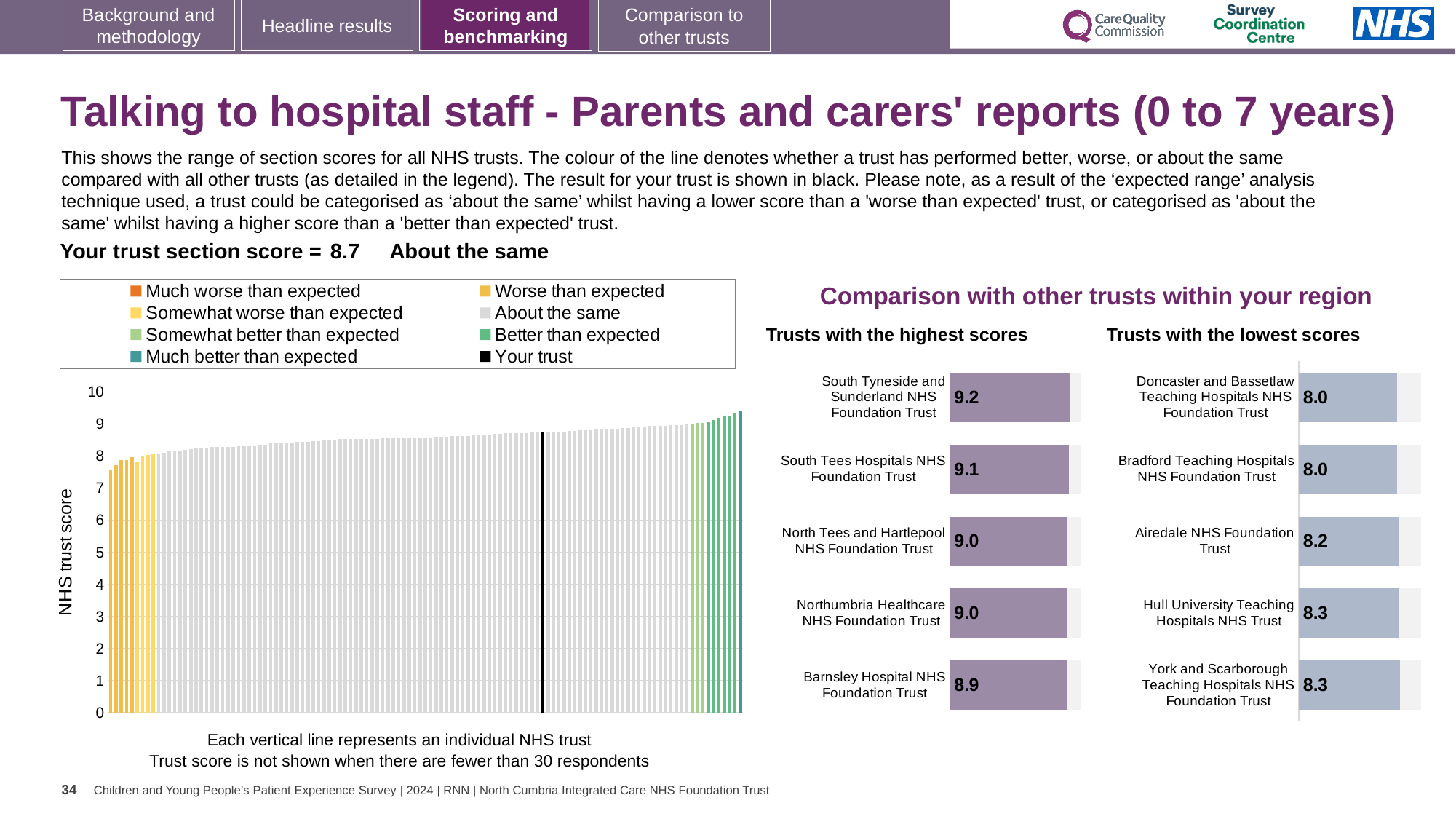
In the main 'NHS trust score' chart, is the value for the black 'Your trust' bar greater or less than 8? greater Which is larger: the score for South Tees Hospitals NHS Foundation Trust in the highest scores chart, or the score for Hull University Teaching Hospitals NHS Trust in the lowest scores chart? South Tees Hospitals NHS Foundation Trust In the 'Trusts with the highest scores' chart, which trust has the lowest score? Barnsley Hospital NHS Foundation Trust In the 'Trusts with the lowest scores' chart, what is the difference between the scores of Airedale NHS Foundation Trust and Doncaster and Bassetlaw Teaching Hospitals NHS Foundation Trust? 0.2 In the 'Trusts with the highest scores' chart, what is the difference between the scores of South Tyneside and Sunderland NHS Foundation Trust and Barnsley Hospital NHS Foundation Trust? 0.3 In the 'Trusts with the highest scores' chart, what is the score for South Tyneside and Sunderland NHS Foundation Trust? 9.2 How many entries does the legend of the main 'NHS trust score' chart list? 8 How many trusts are listed in the 'Trusts with the lowest scores' chart? 5 In the 'Trusts with the lowest scores' chart, what is the score for Airedale NHS Foundation Trust? 8.2 In the 'Trusts with the highest scores' chart, which trust has the highest score? South Tyneside and Sunderland NHS Foundation Trust In the main 'NHS trust score' chart, do the values rise or fall from left to right? Rise What kind of chart is the main chart on the left showing NHS trust scores? Bar chart